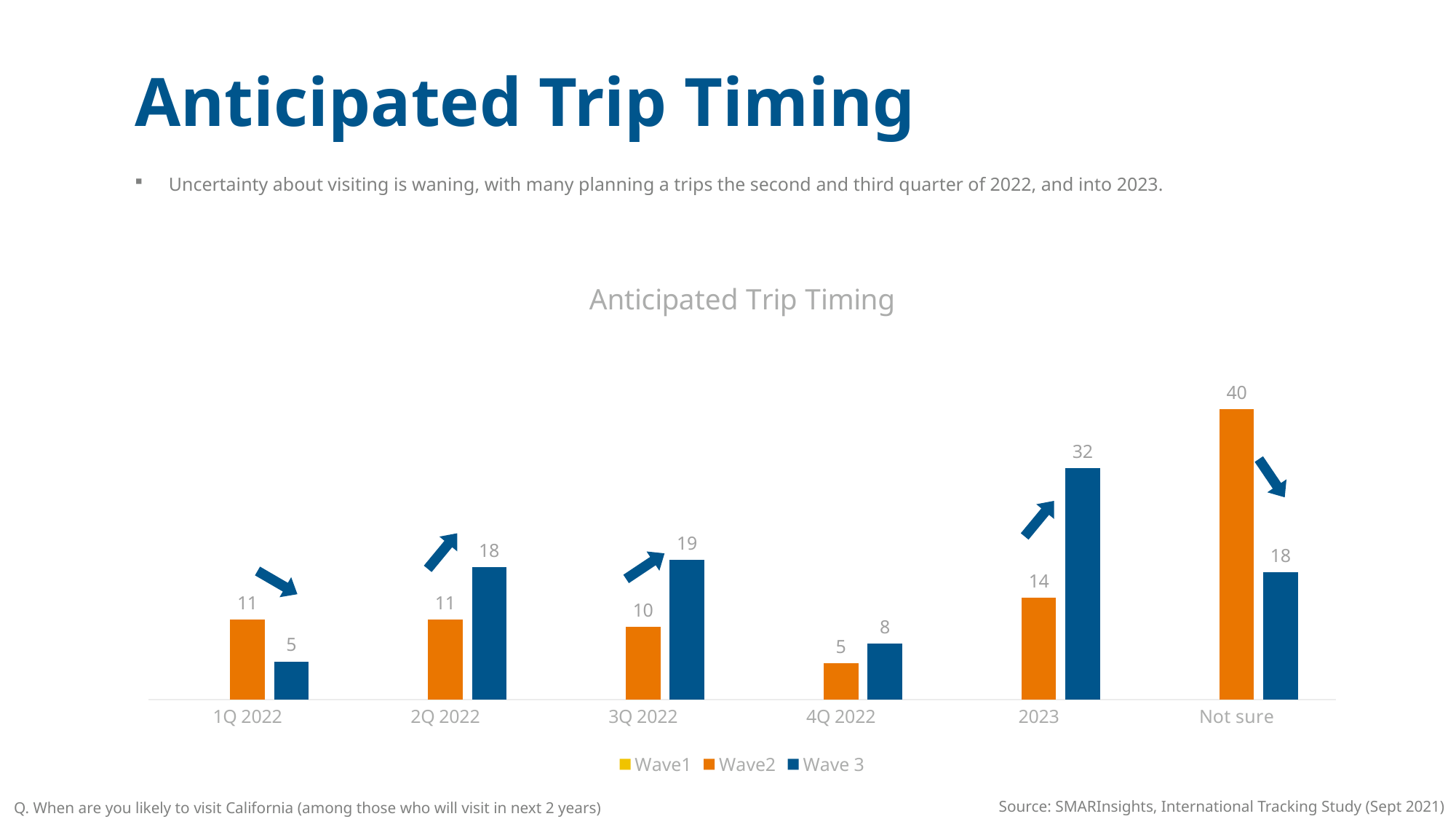
What is the Wave 3 value for 1Q 2022? 5 What is the Wave 3 value for 2023? 32 How many series does the legend list? 3 Which is larger for 2Q 2022, the Wave2 value or the Wave 3 value? Wave 3 What is the title of the chart? Anticipated Trip Timing Which category has the highest Wave 3 value? 2023 What is the Wave2 value for 4Q 2022? 5 What type of chart is shown on the slide? bar chart What is the Wave2 value for 'Not sure'? 40 Which category has the lowest Wave2 value? 4Q 2022 What is the difference between the Wave2 and Wave 3 values for 'Not sure'? 22 How many categories are shown on the x axis? 6